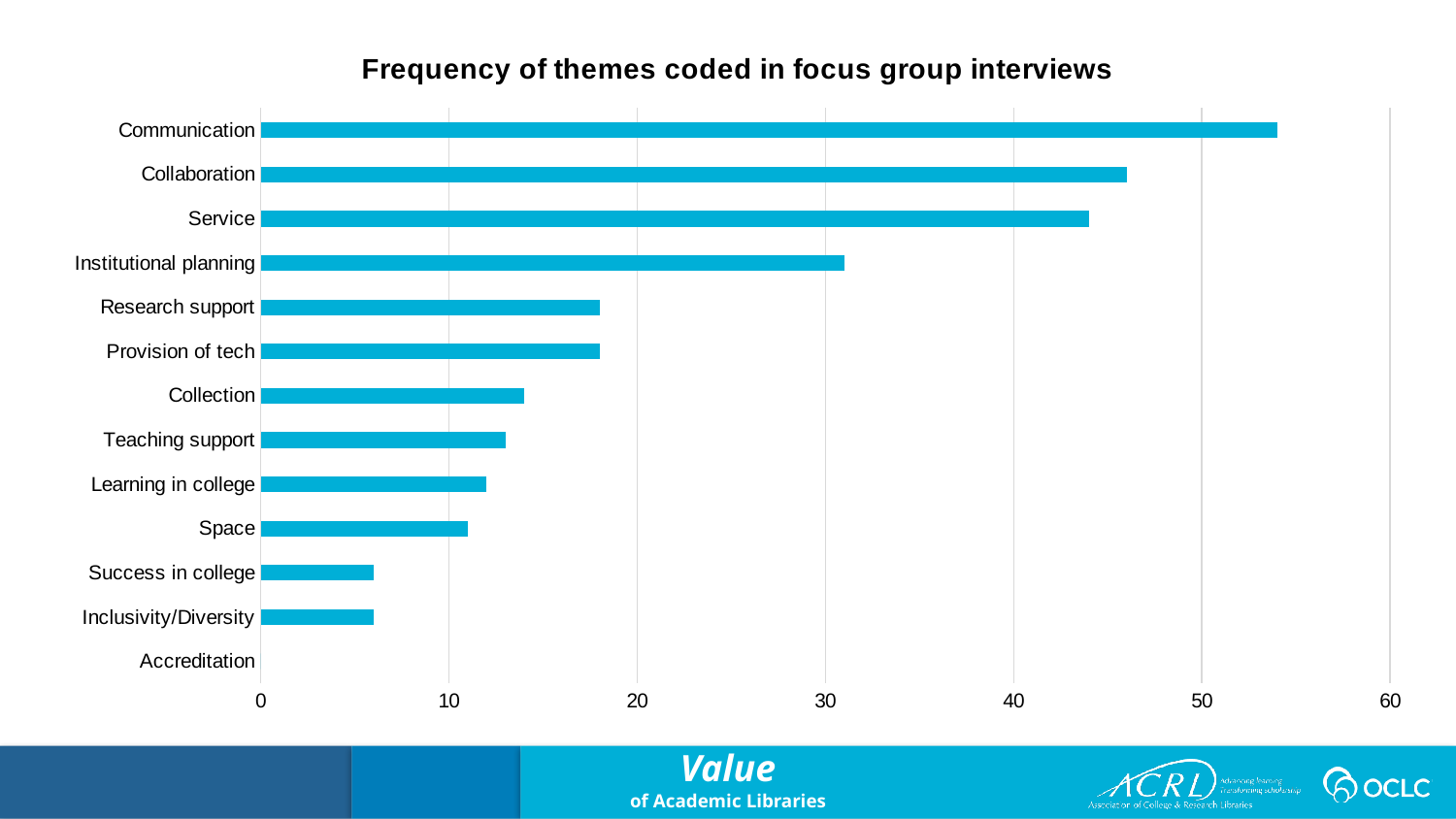
Is the value for Institutional planning greater or less than 30? greater What kind of chart is shown on the slide? bar chart Which theme has the lowest frequency? Accreditation Which is larger, the value for Collaboration or the value for Institutional planning? Collaboration Is the value for Space greater or less than 10? greater Is the value for Communication greater or less than 50? greater What is the title of the chart? Frequency of themes coded in focus group interviews How many themes (categories) are listed on the chart? 13 Which is larger, the value for Collection or the value for Space? Collection Which theme has the highest frequency? Communication